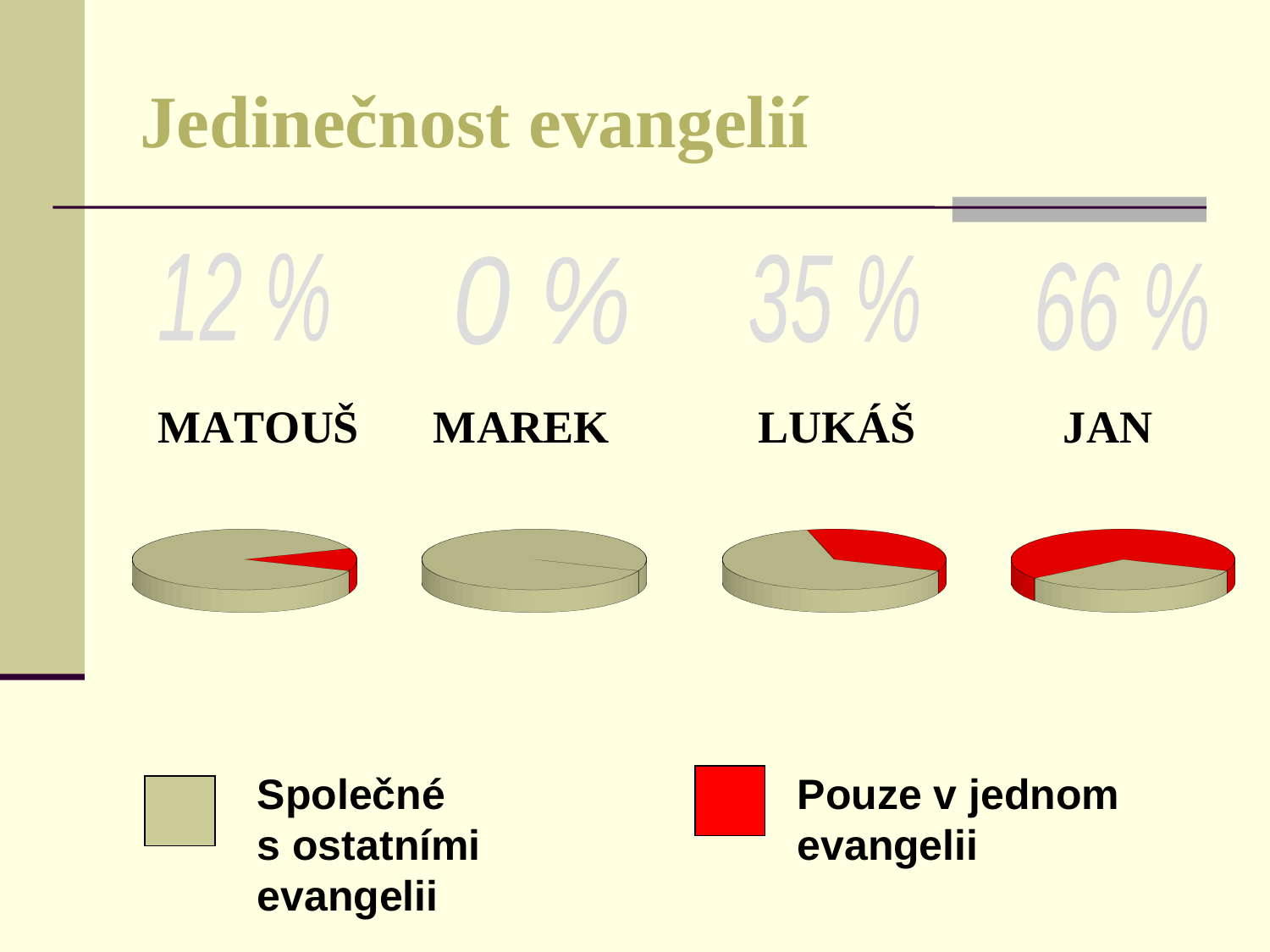
What does the red colour in the legend represent? Pouze v jednom evangelii Which gospel has the largest red slice (Pouze v jednom evangelii)? JAN In the MATOUŠ pie chart, what share of the pie is the beige slice (Společné s ostatními evangelii)? 88 % What percentage is shown above the LUKÁŠ pie chart? 35 % How many pie charts are shown on the slide? 4 Which gospel has the smallest red slice (Pouze v jednom evangelii)? MAREK What percentage is shown above the MATOUŠ pie chart? 12 % What kind of charts are shown on the slide? Pie charts Which has a larger red slice, the LUKÁŠ pie chart or the MATOUŠ pie chart? LUKÁŠ What is the difference between the percentage shown for JAN and the percentage shown for LUKÁŠ? 31 % What percentage is shown above the MAREK pie chart? 0 % What percentage is shown above the JAN pie chart? 66 %